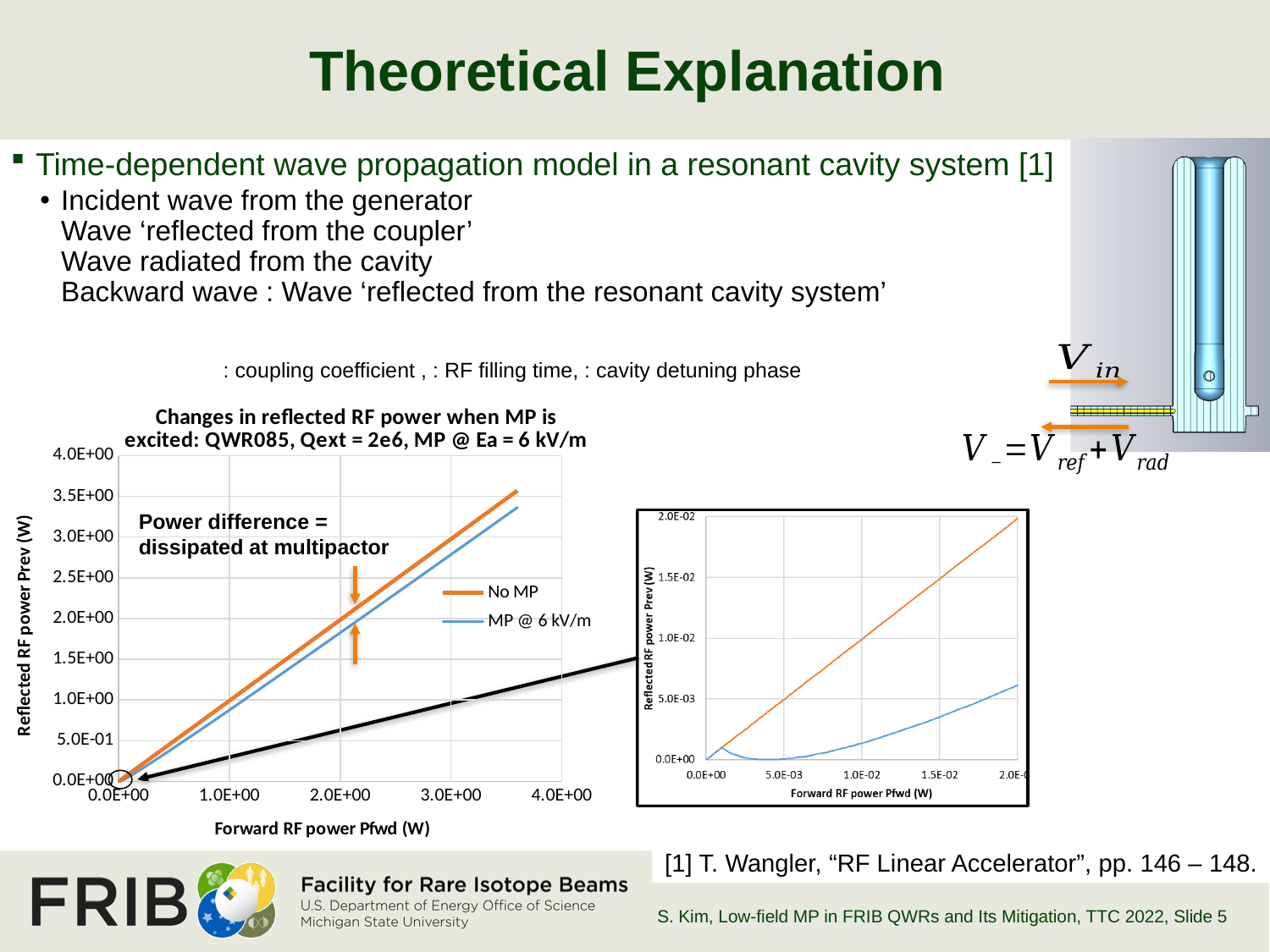
In the inset chart on the right of the slide, is the orange line's value at a forward RF power of 1.5E-02 W greater or less than 1.0E-02? greater What type of chart is the chart titled 'Changes in reflected RF power when MP is excited'? line chart In the inset chart on the right of the slide, which line is higher at a forward RF power of 1.5E-02 W: the orange line or the blue line? the orange line In the chart titled 'Changes in reflected RF power when MP is excited', what is the x-axis title? Forward RF power Pfwd (W) In the chart titled 'Changes in reflected RF power when MP is excited', which series has the higher reflected RF power at a forward RF power of 3.0E+00 W: 'No MP' or 'MP @ 6 kV/m'? No MP How many series does the legend of the chart titled 'Changes in reflected RF power when MP is excited' list? 2 In the chart titled 'Changes in reflected RF power when MP is excited', what are the two legend entries? No MP and MP @ 6 kV/m In the chart titled 'Changes in reflected RF power when MP is excited', does the 'No MP' series rise or fall as forward RF power increases? rise In the chart titled 'Changes in reflected RF power when MP is excited', is the 'No MP' reflected power at a forward RF power of 3.0E+00 W greater or less than 2.5E+00? greater In the chart titled 'Changes in reflected RF power when MP is excited', is the 'MP @ 6 kV/m' reflected power at a forward RF power of 1.0E+00 W greater or less than 1.5E+00? less In the inset chart on the right of the slide, does the blue line rise or fall between a forward RF power of 1.0E-02 W and 2.0E-02 W? rise In the chart titled 'Changes in reflected RF power when MP is excited', what is the maximum value shown on the y-axis? 4.0E+00